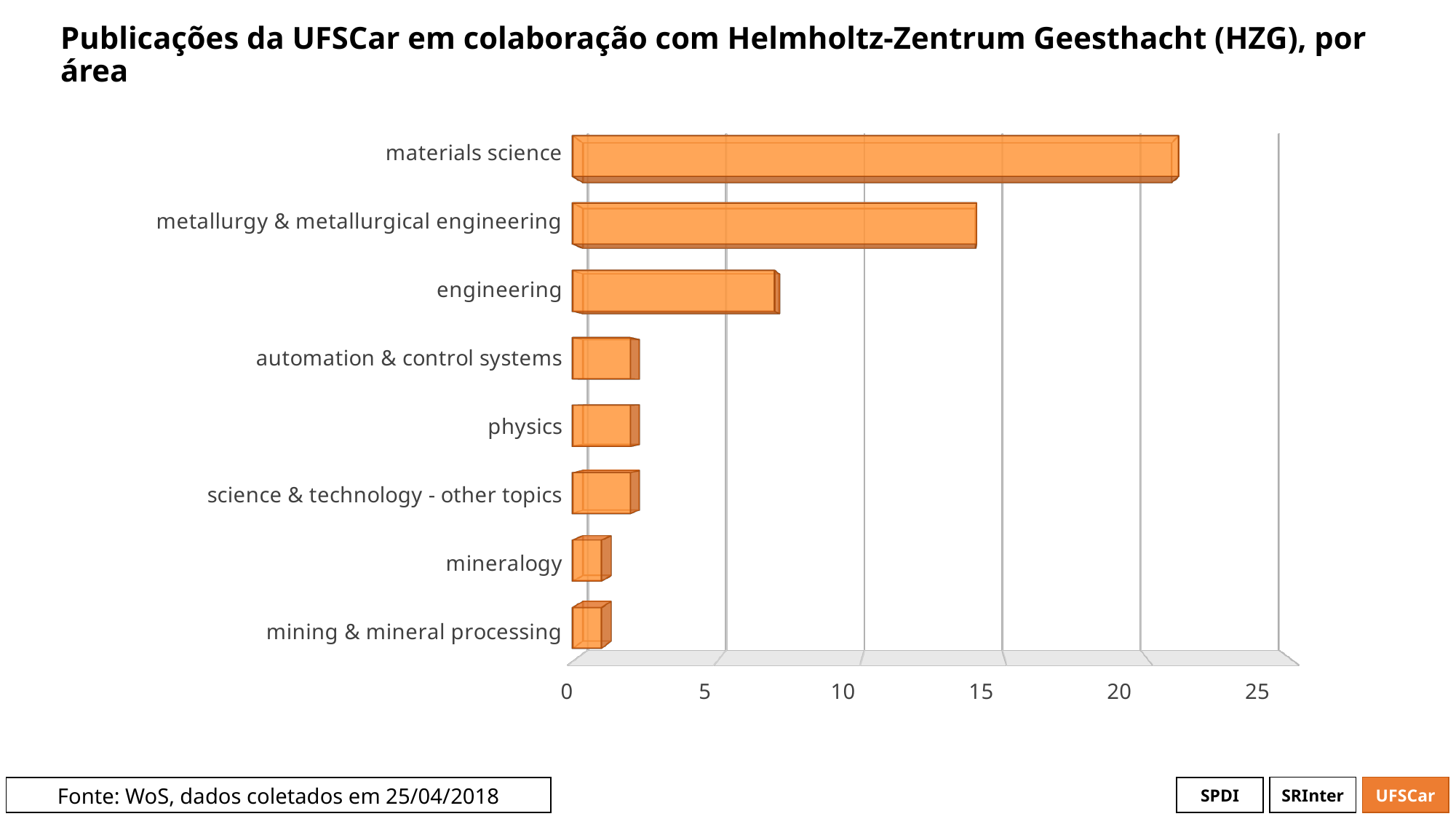
Which has more publications, materials science or metallurgy & metallurgical engineering? materials science Is the value for engineering greater or less than 5? greater Is the value for engineering greater or less than 10? less What kind of chart is shown on the slide? bar chart Is the value for mineralogy greater or less than 5? less Which has more publications, engineering or physics? engineering Which area has the highest number of publications? materials science What is the highest value shown on the horizontal axis? 25 How many areas (categories) are shown in the chart? 8